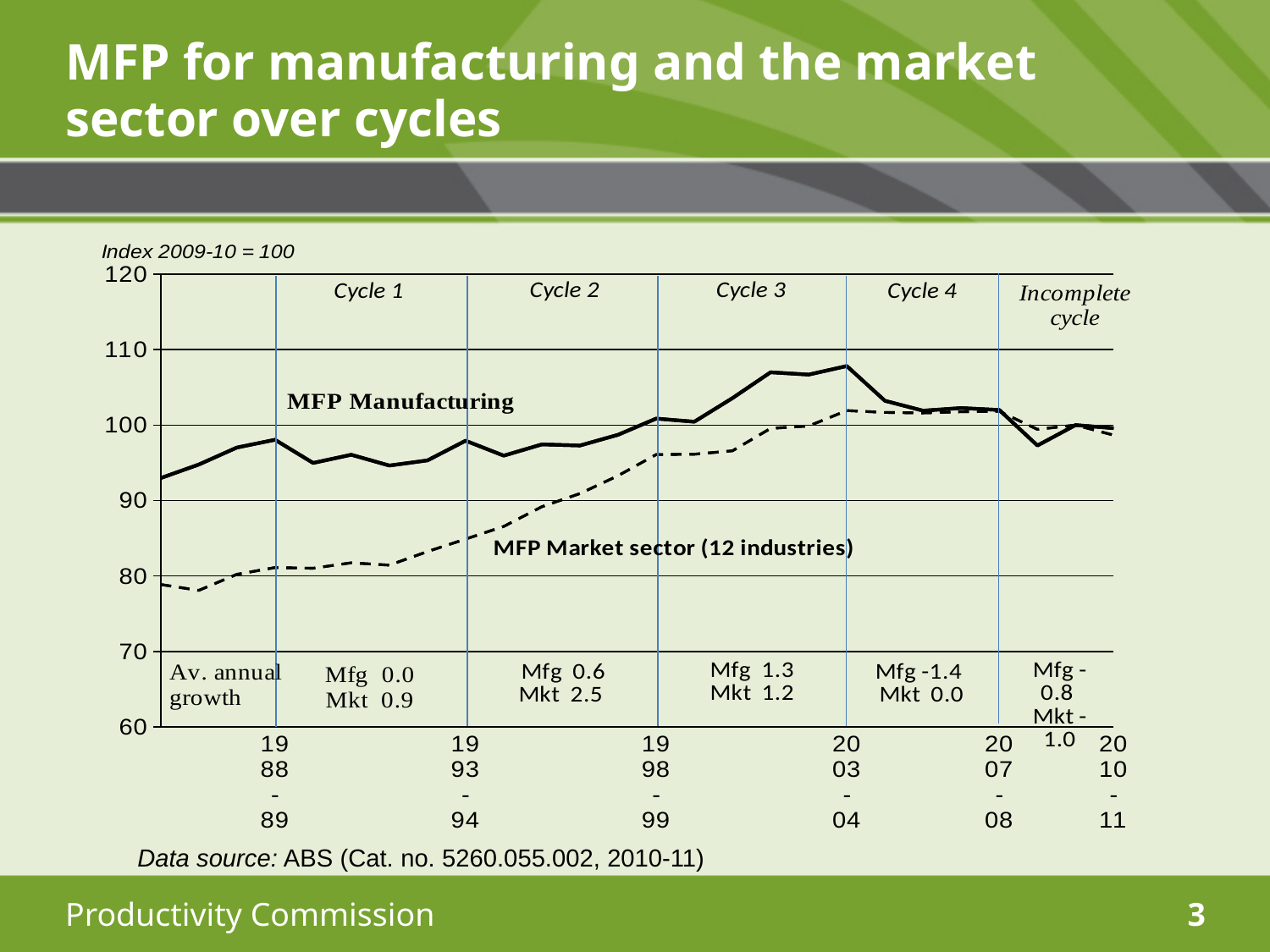
What is the average annual growth for Mfg in Cycle 2? 0.6 Is the value of MFP Manufacturing in 1988-89 greater or less than 90? greater In 1988-89, which series has the higher value, MFP Manufacturing or MFP Market sector (12 industries)? MFP Manufacturing Is the value of MFP Market sector (12 industries) in 1993-94 greater or less than 90? less Which cycle has the highest average annual growth for Mkt? Cycle 2 What kind of chart is shown on the slide? line chart Does the MFP Market sector (12 industries) line generally rise or fall from 1988-89 to 2010-11? rise What is the average annual growth for Mkt in Cycle 3? 1.2 What are the two series plotted on the chart? MFP Manufacturing and MFP Market sector (12 industries) Which cycle has the lowest average annual growth for Mfg? Cycle 4 What is the index base stated above the chart? Index 2009-10 = 100 How many series are plotted on the chart? 2